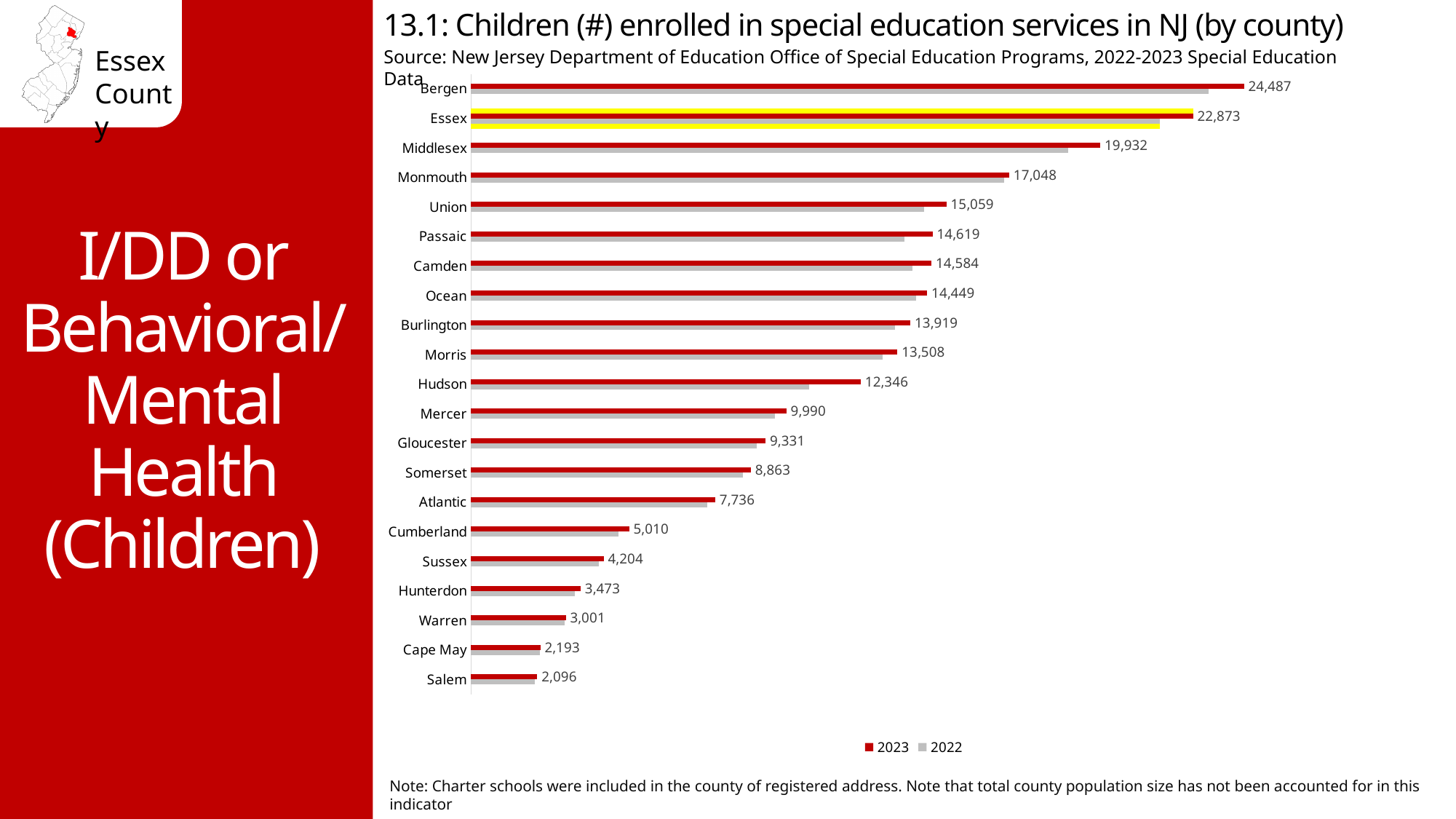
What is the difference between the 2023 values for Bergen and Essex counties? 1,614 How many series does the legend list? 2 Which county has the lowest number of children enrolled in special education services in 2023? Salem How many children were enrolled in special education services in Essex County in 2023? 22,873 Which county has the highest number of children enrolled in special education services in 2023? Bergen What is the 2023 value for Cape May County? 2,193 Which years are shown in the chart legend? 2023 and 2022 What type of chart is shown on the slide? Bar chart How many counties are shown in the chart? 21 Which county had more children enrolled in 2023, Monmouth or Union? Monmouth What is the 2023 value for Hudson County? 12,346 What is the 2023 value for Middlesex County? 19,932